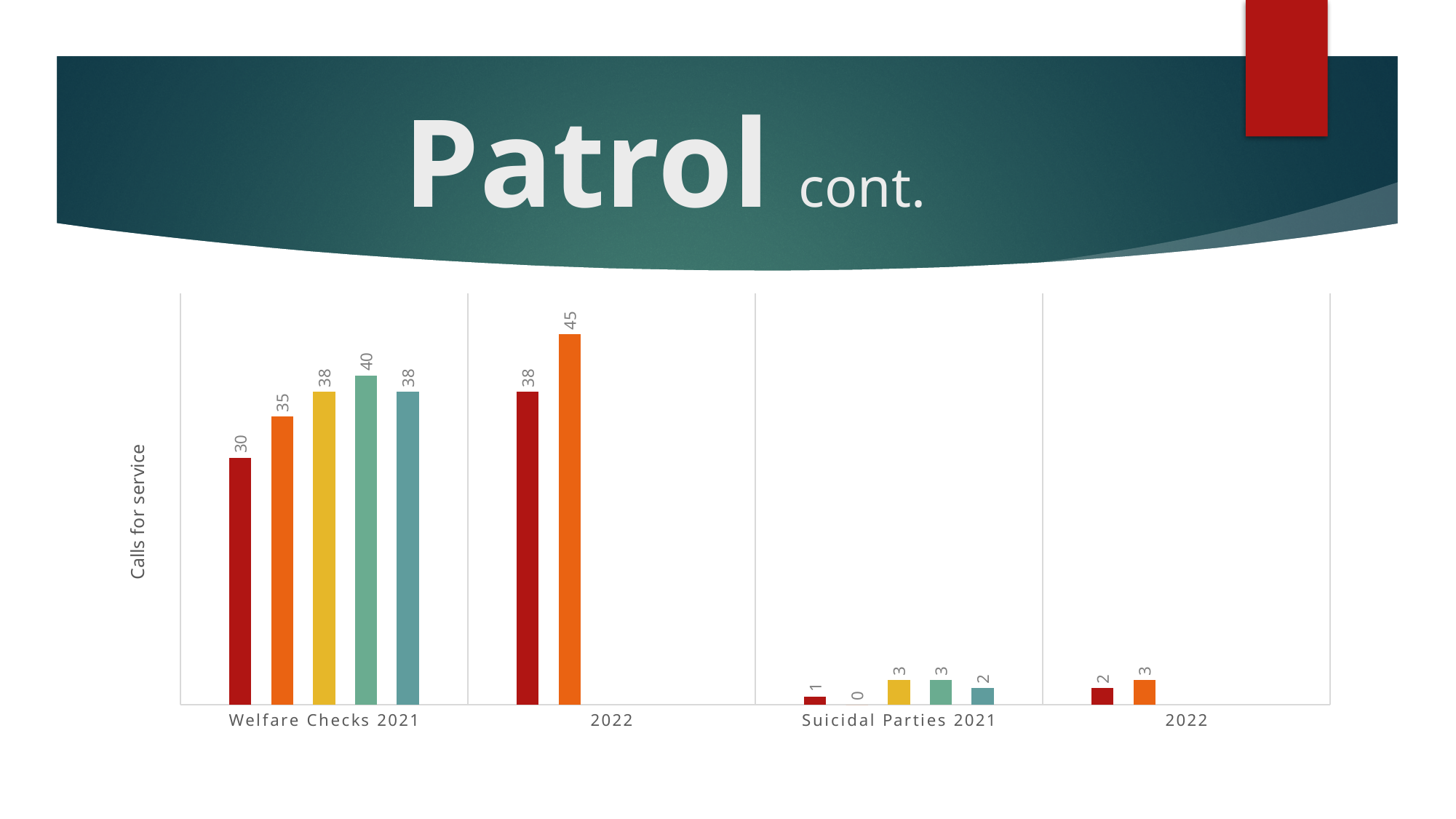
Which bar in the Welfare Checks 2021 group has the highest value? the green (fourth) bar, 40 How many bars are plotted in the Suicidal Parties 2021 group? 5 What is the value of the orange (second) bar in the 2022 group next to Welfare Checks 2021? 45 Which is larger: the red bar in the Welfare Checks 2021 group or the red bar in the 2022 group beside it? the red bar in the 2022 group (38) What is the difference between the orange bar and the red bar in the 2022 group next to Welfare Checks 2021? 7 Which bar in the Welfare Checks 2021 group has the lowest value? the red (first) bar, 30 What kind of chart is shown on the slide? bar chart What is the value of the red (first) bar in the Welfare Checks 2021 group? 30 What is the value of the green (fourth) bar in the Welfare Checks 2021 group? 40 What is the label on the vertical axis of the chart? Calls for service How many categories are labelled on the x axis of the chart? 4 What is the value of the orange (second) bar in the Suicidal Parties 2021 group? 0